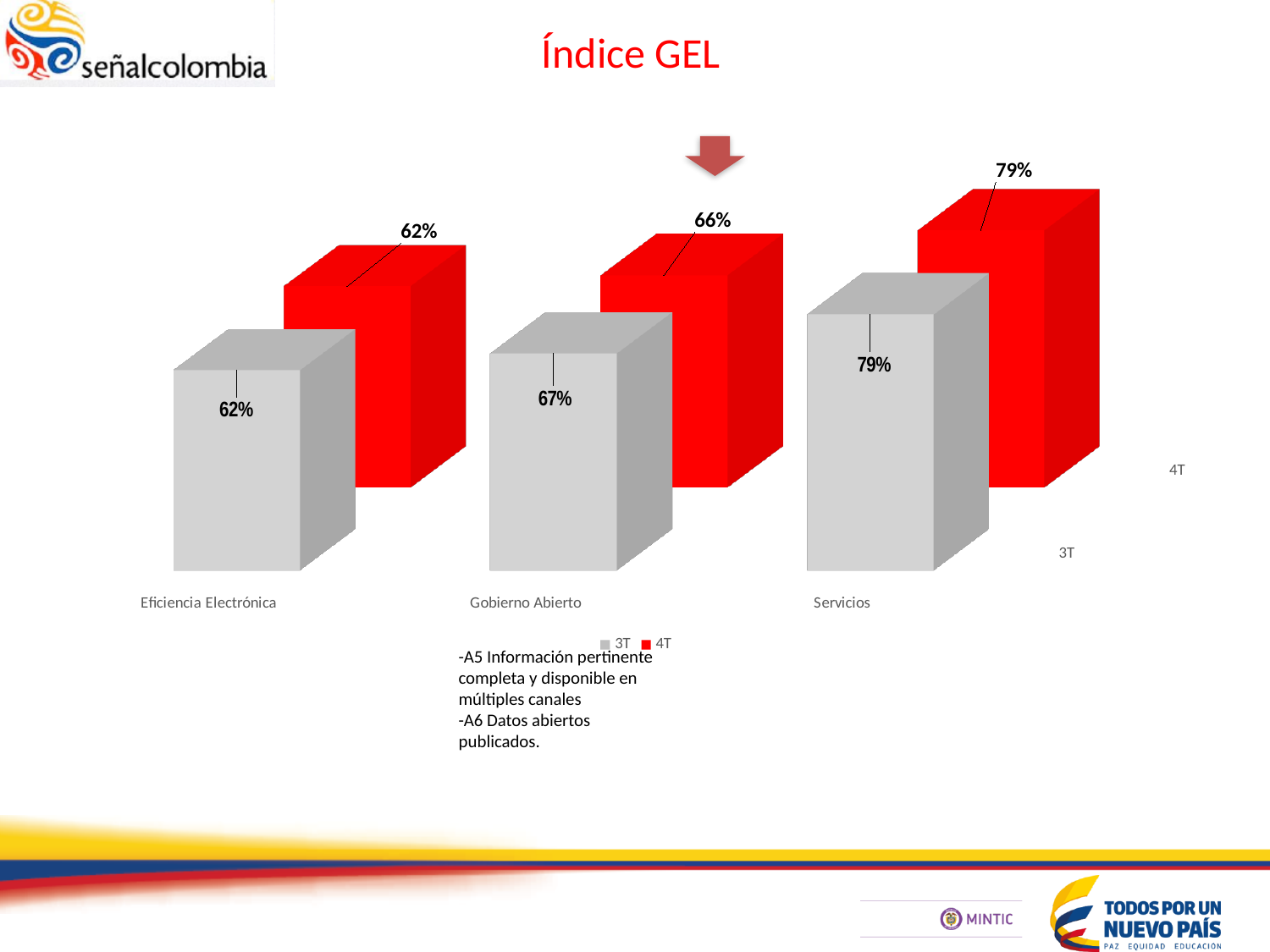
How many series does the legend list? 2 What is the 3T value for Gobierno Abierto? 67% Which colour represents the 4T series? Red What is the 4T value for Gobierno Abierto? 66% Which category has the highest 4T value? Servicios Which category has the lowest 3T value? Eficiencia Electrónica What is the 3T value for Eficiencia Electrónica? 62% What is the difference between the 3T and 4T values for Gobierno Abierto? 1% What is the difference between the 4T values for Servicios and Eficiencia Electrónica? 17% What is the 4T value for Servicios? 79% What kind of chart is shown on the slide? Bar chart How many categories are shown on the x axis? 3